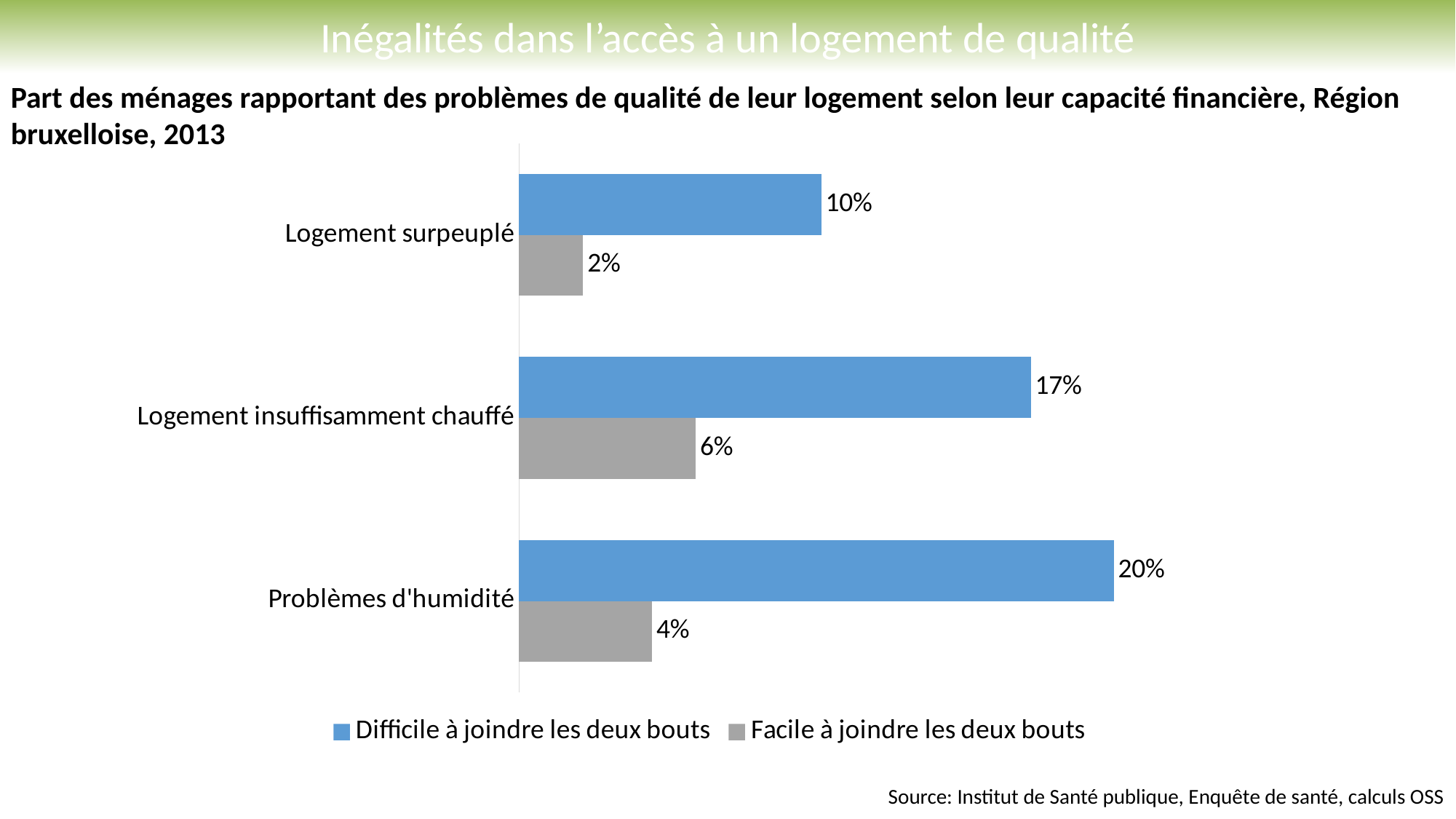
What is the value for "Facile à joindre les deux bouts" in the "Problèmes d'humidité" category? 4% How many categories are shown on the chart? 3 What is the value for "Facile à joindre les deux bouts" in the "Logement insuffisamment chauffé" category? 6% Which is larger: the "Facile à joindre les deux bouts" value for "Logement insuffisamment chauffé" or for "Problèmes d'humidité"? Logement insuffisamment chauffé What is the difference between the "Difficile à joindre les deux bouts" values for "Logement insuffisamment chauffé" and "Logement surpeuplé"? 7% What is the difference between the two series in the "Problèmes d'humidité" category? 16% What kind of chart is shown on the slide? Bar chart Which colour represents the "Facile à joindre les deux bouts" series? Grey Which category has the lowest value for "Facile à joindre les deux bouts"? Logement surpeuplé How many series does the legend list? 2 Which category has the highest value for "Difficile à joindre les deux bouts"? Problèmes d'humidité What is the value for "Difficile à joindre les deux bouts" in the "Logement surpeuplé" category? 10%